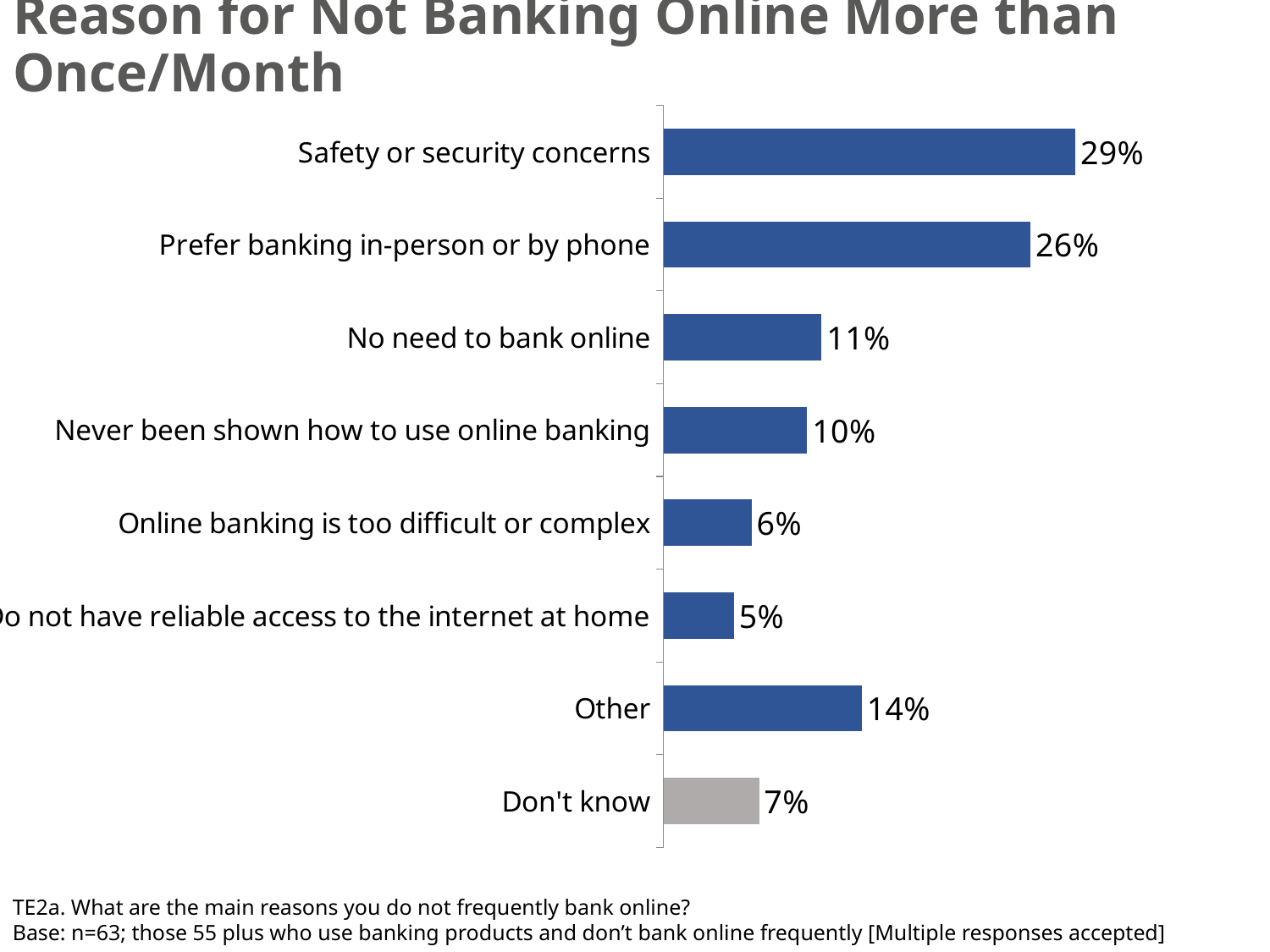
What is the difference between 'Other' and 'Don't know'? 7% Which reason has the lowest percentage? Do not have reliable access to the internet at home What type of chart is shown on the slide? Bar chart Which is larger: 'No need to bank online' or 'Online banking is too difficult or complex'? No need to bank online Which category's bar is shown in grey rather than blue? Don't know What percentage said they have never been shown how to use online banking? 10% What is the difference between 'Safety or security concerns' and 'Prefer banking in-person or by phone'? 3% What is the value for 'Other'? 14% What percentage cited safety or security concerns as a reason for not banking online more than once a month? 29% What is the value for 'Prefer banking in-person or by phone'? 26% Which reason has the highest percentage? Safety or security concerns How many reasons (categories) are shown in the chart? 8